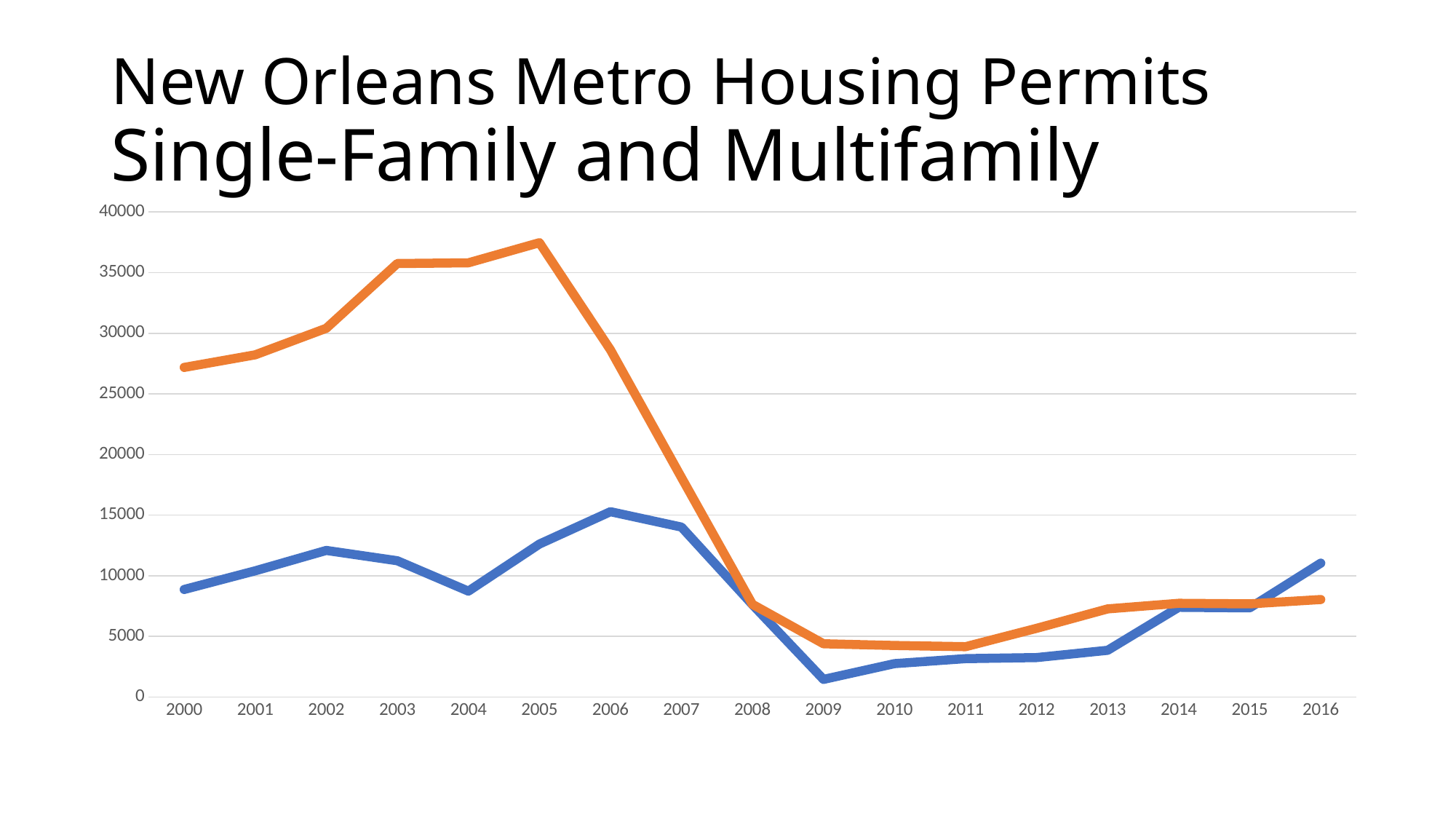
In 2016, which line has the higher value, the orange line or the blue line? blue line How many years are plotted along the x axis? 17 Is the value of the orange line in 2000 greater or less than 25000? greater Is the value of the blue line in 2009 greater or less than 5000? less What kind of chart is shown on the slide? line chart Does the orange line rise or fall between 2005 and 2009? fall In which year does the orange line reach its highest value? 2005 Is the value of the orange line in 2005 greater or less than 35000? greater In which year does the blue line reach its highest value? 2006 In 2003, which line has the higher value, the orange line or the blue line? orange line In which year does the blue line reach its lowest value? 2009 How many lines are plotted on the chart? 2